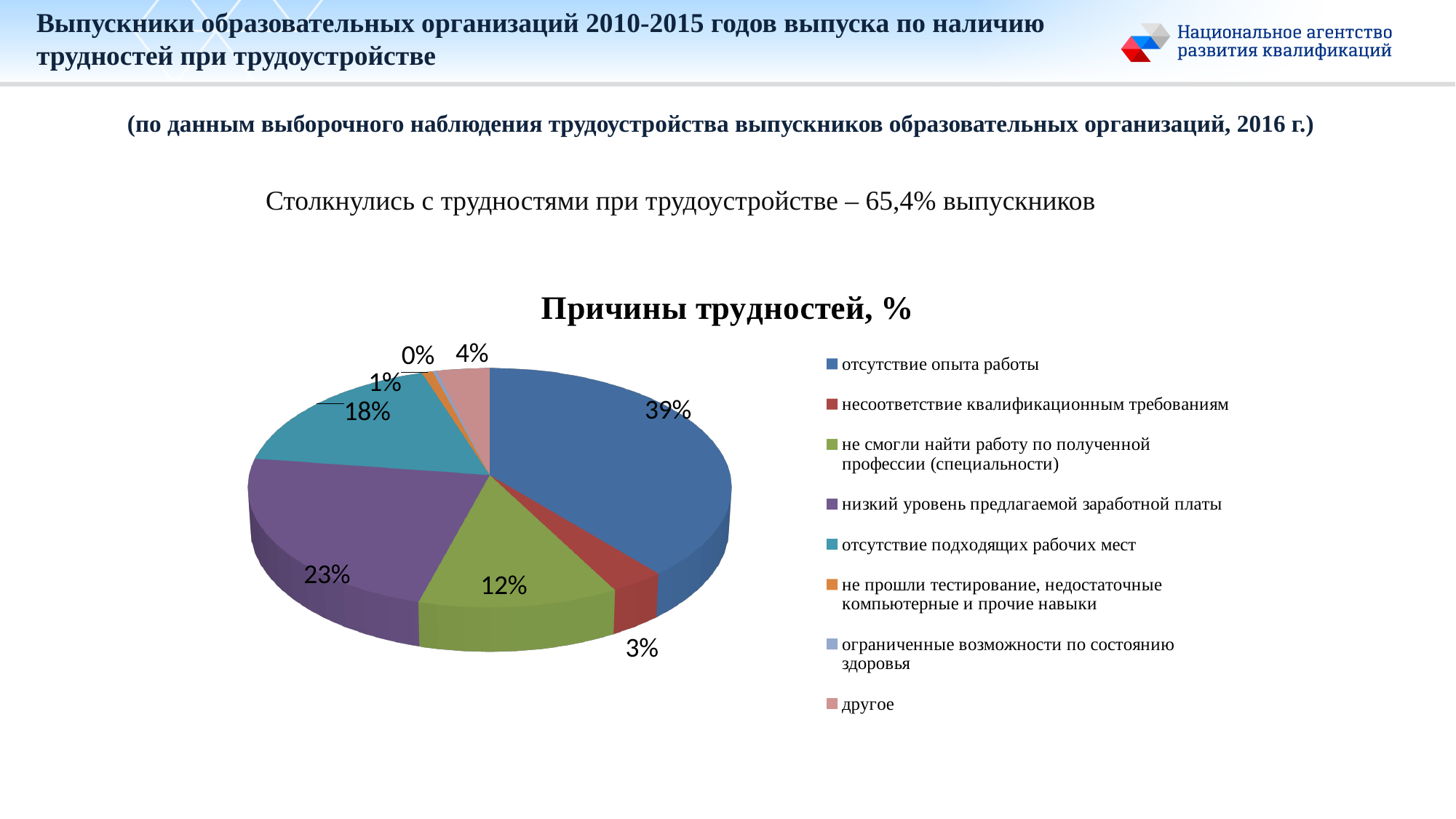
What is the difference in percentage points between 'отсутствие опыта работы' and 'низкий уровень предлагаемой заработной платы'? 16 What type of chart is shown on the slide? pie chart What percentage is given for 'не смогли найти работу по полученной профессии (специальности)'? 12% Which is larger: the share for 'несоответствие квалификационным требованиям' or for 'другое'? другое What percentage is shown for 'низкий уровень предлагаемой заработной платы'? 23% What share is shown for 'другое'? 4% How many categories does the legend list? 8 What value is labelled for 'отсутствие подходящих рабочих мест'? 18% Which reason has the largest slice of the pie? отсутствие опыта работы What is the title of the chart? Причины трудностей, % Which reason has the smallest slice, labelled 0%? ограниченные возможности по состоянию здоровья What share of the pie does 'отсутствие опыта работы' account for? 39%